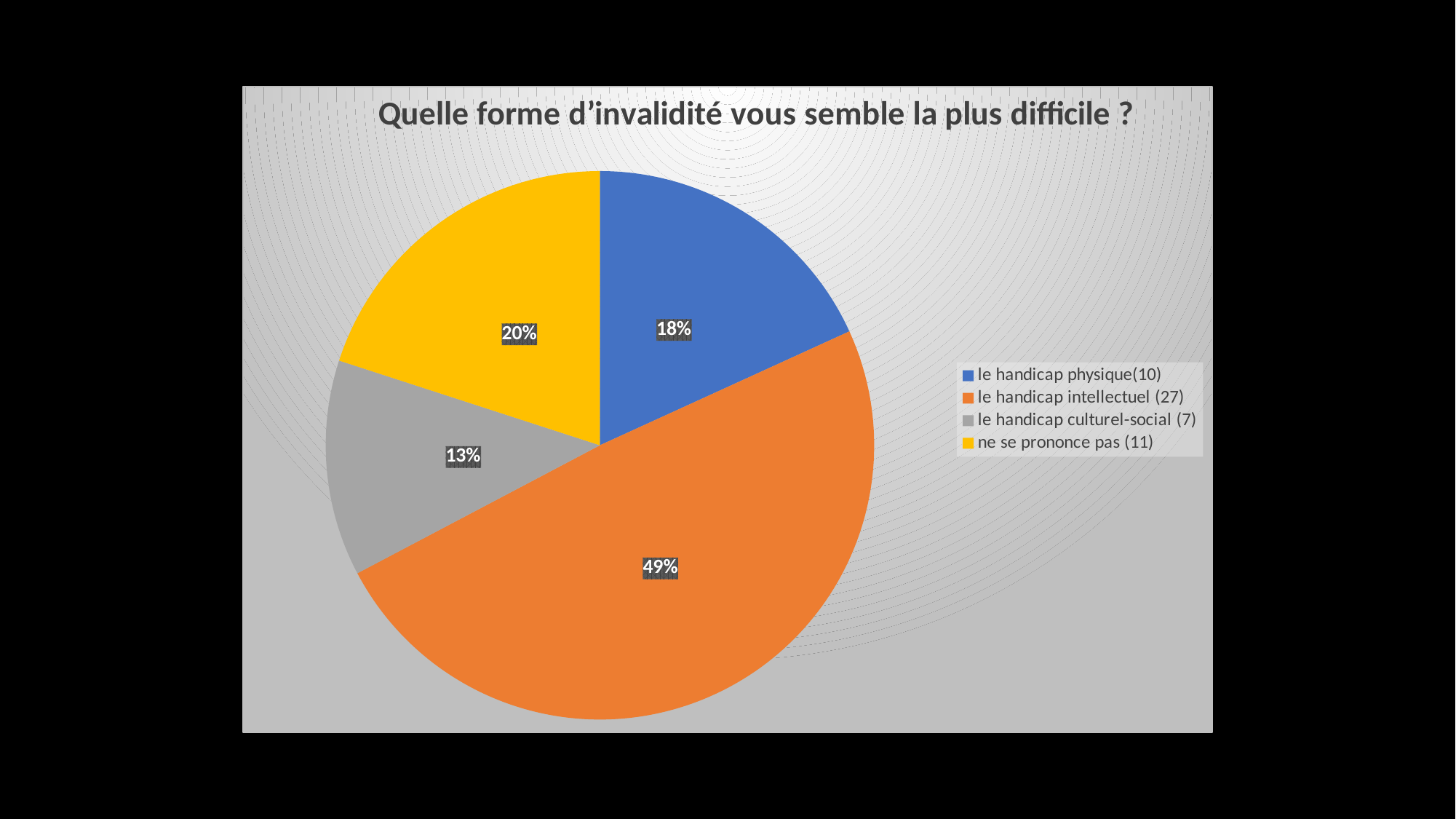
What kind of chart is shown on the slide? pie chart What is the difference in percentage points between the 'le handicap intellectuel (27)' slice and the 'ne se prononce pas (11)' slice? 29 percentage points What percentage share does 'le handicap physique(10)' have in the pie? 18% What colour is the slice for 'le handicap culturel-social (7)'? grey What is the title of the chart? Quelle forme d'invalidité vous semble la plus difficile ? What percentage share does 'le handicap intellectuel (27)' have in the pie? 49% Which category has the smallest slice of the pie? le handicap culturel-social (7) How many categories does the pie chart show? 4 What percentage share does 'ne se prononce pas (11)' have in the pie? 20% Which slice is larger: 'le handicap physique(10)' or 'ne se prononce pas (11)'? ne se prononce pas (11) Which category has the largest slice of the pie? le handicap intellectuel (27)